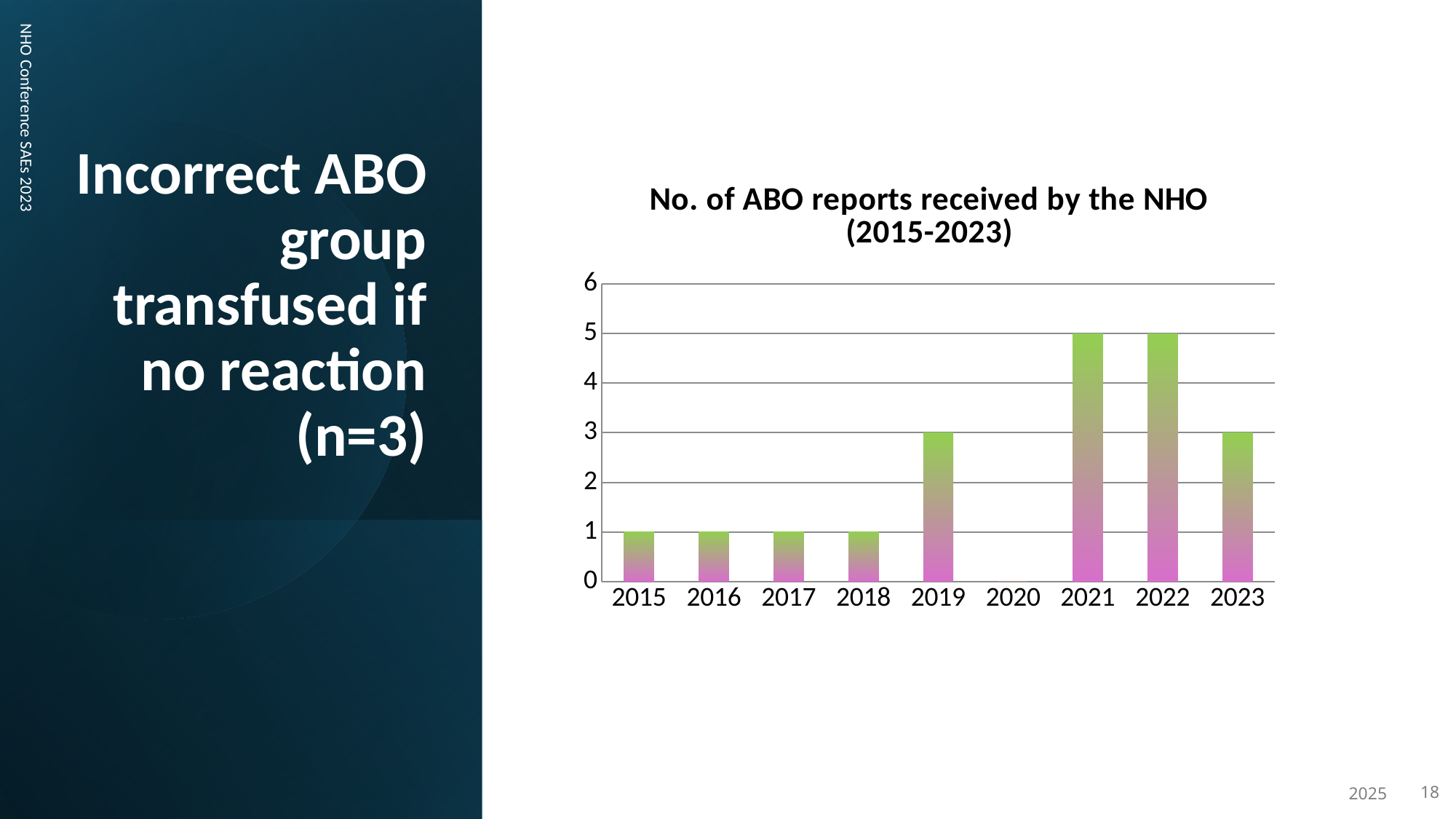
Which year has the lowest number of ABO reports? 2020 What is the highest value shown on the y axis? 6 Which is larger, the value for 2019 or the value for 2018? 2019 How many years are shown on the x axis? 9 What kind of chart is shown on the slide? Bar chart What is the value for 2021 in the chart? 5 What is the title of the chart? No. of ABO reports received by the NHO (2015-2023) What is the difference between the values for 2022 and 2023? 2 What is the value for 2019 in the chart? 3 What is the value for 2015 in the chart? 1 Which two years share the highest number of ABO reports? 2021 and 2022 What is the value for 2020 in the chart? 0